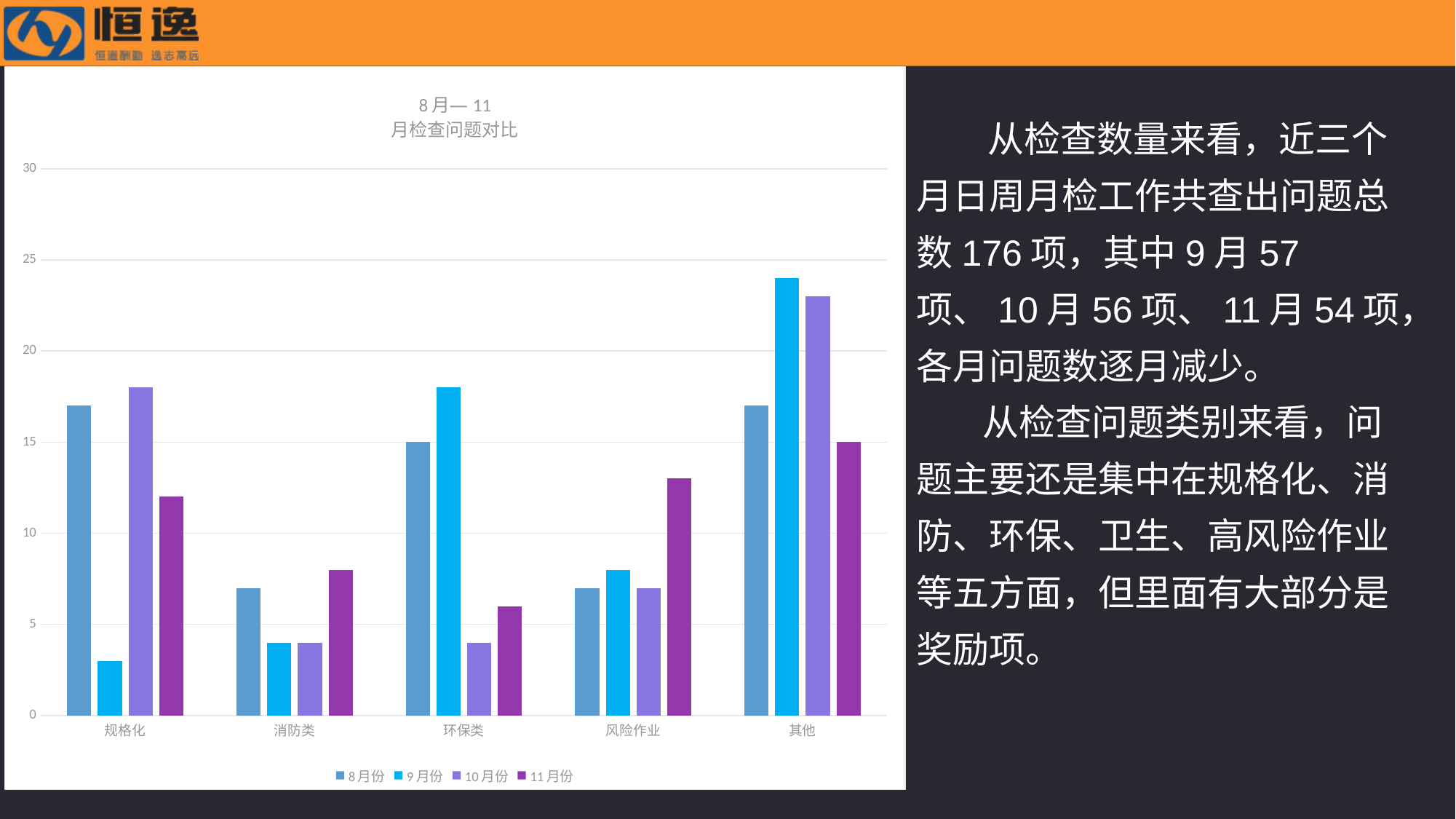
In the 环保类 category, which is larger: the 9月份 value or the 10月份 value? 9月份 How many categories are shown on the x axis of the chart? 5 Which category has the lowest bar for the 9月份 series? 规格化 How many series does the chart legend list? 4 What is the value for 11月份 in the 其他 category? 15 What is the title of the chart? 8月—11月检查问题对比 Is the value for 11月份 in the 风险作业 category greater or less than 10? greater Is the value for 9月份 in the 其他 category greater or less than 20? greater What is the value for 8月份 in the 环保类 category? 15 Is the value for 9月份 in the 规格化 category greater or less than 5? less What kind of chart is shown on the slide? bar chart Which category has the highest bar for the 9月份 series? 其他